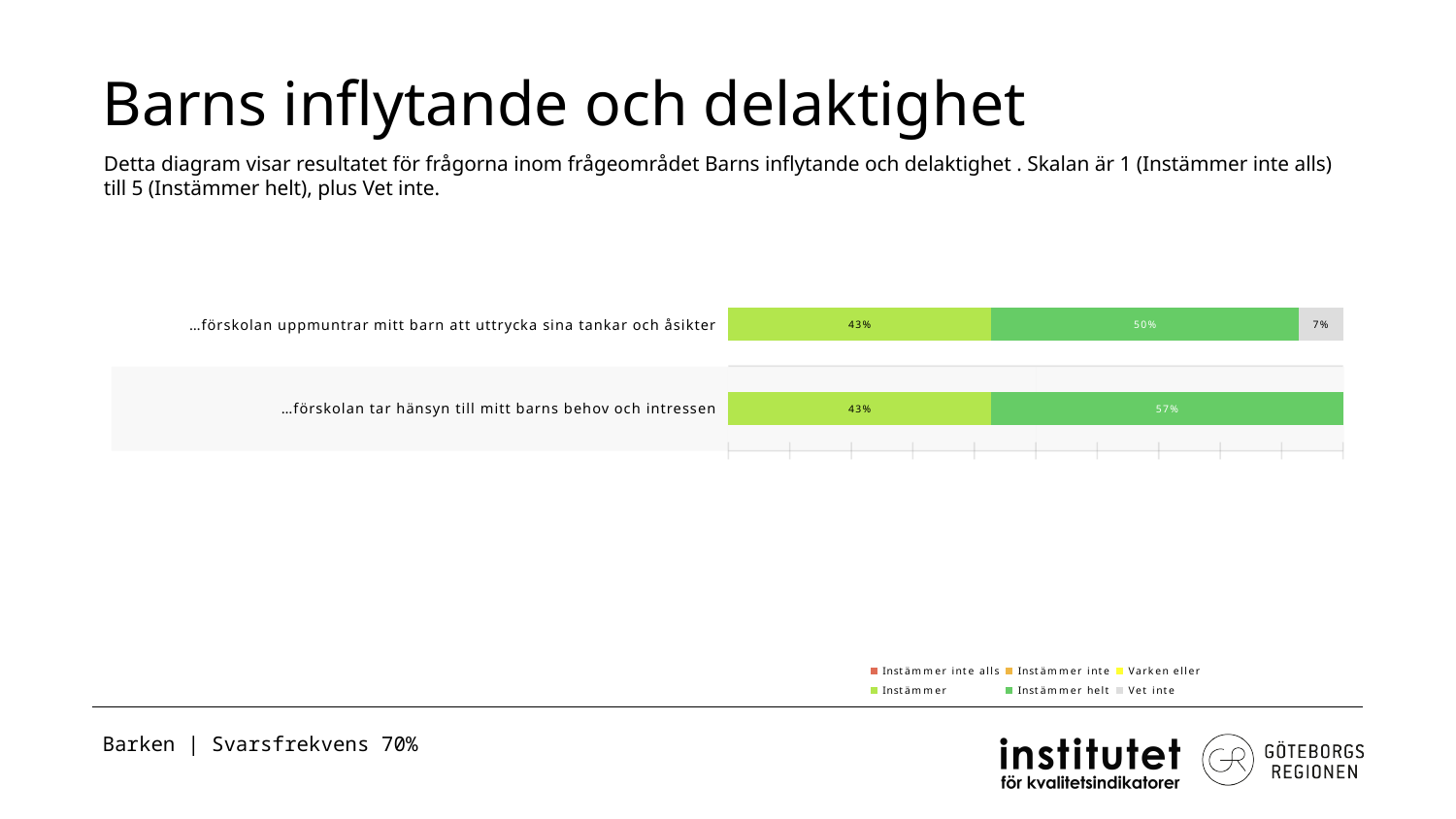
Which legend entry is shown in the lightest grey colour? Vet inte What is the 'Vet inte' value for '…förskolan uppmuntrar mitt barn att uttrycka sina tankar och åsikter'? 7% What is the 'Instämmer helt' value for '…förskolan tar hänsyn till mitt barns behov och intressen'? 57% What kind of chart is shown on the slide? Stacked bar chart For '…förskolan uppmuntrar mitt barn att uttrycka sina tankar och åsikter', which is larger: 'Instämmer' or 'Instämmer helt'? Instämmer helt What is the 'Instämmer' value for '…förskolan tar hänsyn till mitt barns behov och intressen'? 43% How many series does the legend list? 6 What is the total of the labelled segments in the bar for '…förskolan uppmuntrar mitt barn att uttrycka sina tankar och åsikter'? 100% How many categories (questions) are plotted in the chart? 2 What is the difference between the 'Instämmer helt' values of the two categories? 7% Which category has the higher 'Instämmer helt' value? …förskolan tar hänsyn till mitt barns behov och intressen What is the 'Instämmer helt' value for '…förskolan uppmuntrar mitt barn att uttrycka sina tankar och åsikter'? 50%